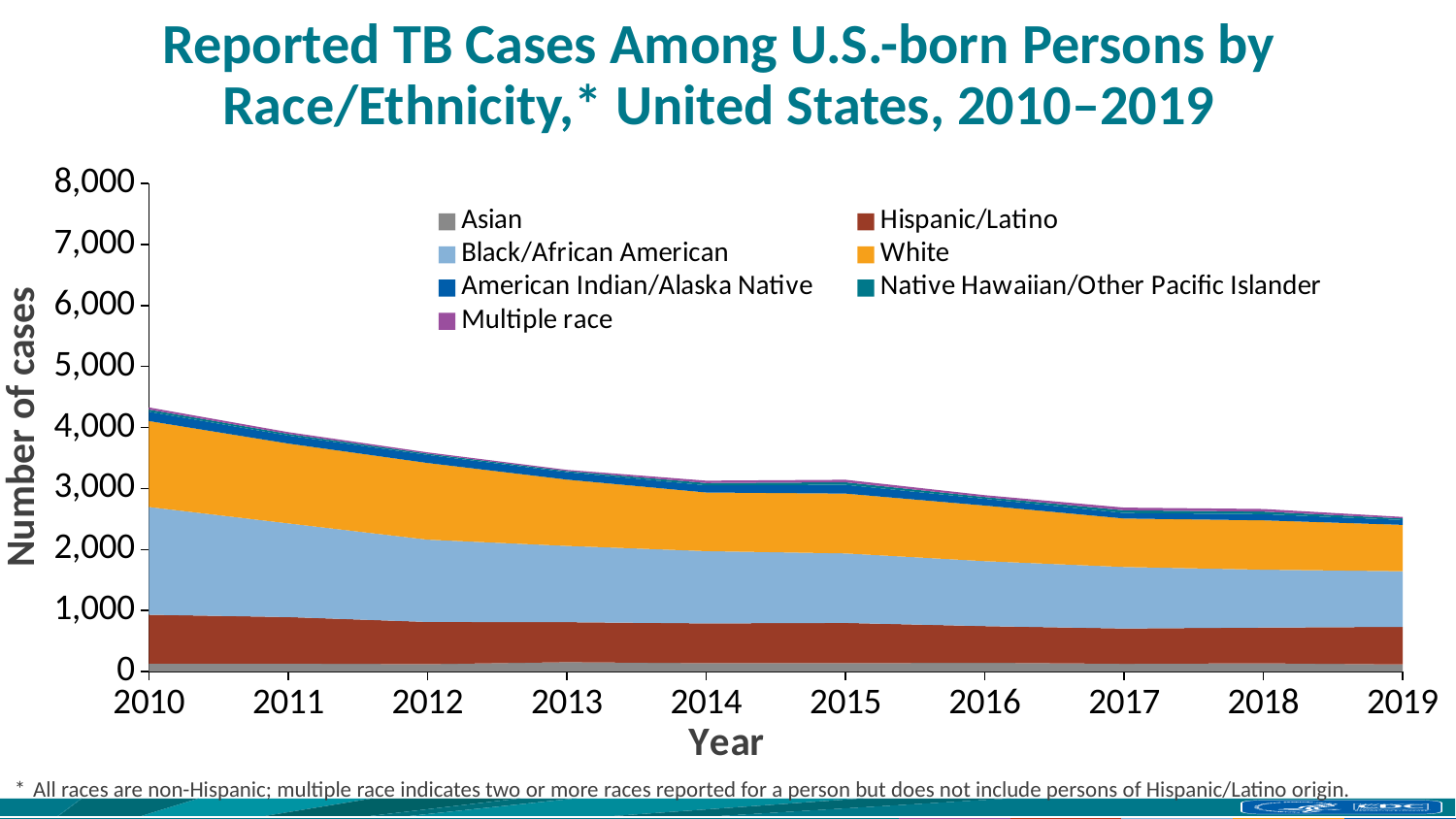
What is the title of the chart? Reported TB Cases Among U.S.-born Persons by Race/Ethnicity,* United States, 2010–2019 Is the total number of cases in 2019 greater or less than 3,000? less In which year is the total number of reported TB cases highest? 2010 What kind of chart is shown on the slide? Stacked area chart Do the total reported TB cases among U.S.-born persons rise or fall from 2010 to 2019? Fall Which series is shown in orange in the legend? White How many series does the legend list? 7 In which year is the total number of reported TB cases lowest? 2019 How many years are shown along the x axis? 10 Is the total number of cases in 2010 greater or less than 4,000? greater Which is larger in 2010: the number of cases among Black/African American persons or among White persons? Black/African American Is the total number of cases in 2017 greater or less than 2,000? greater